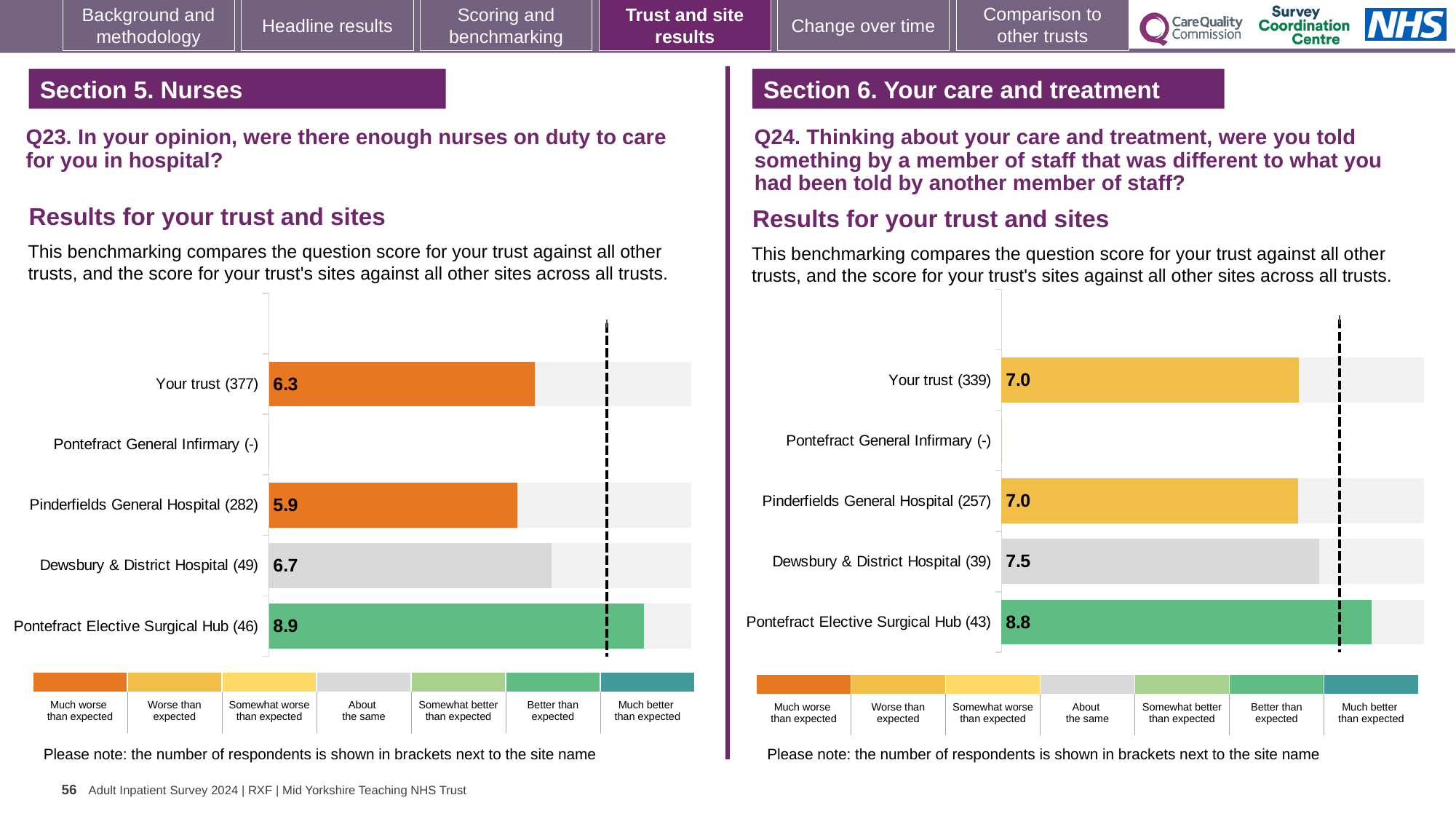
In the Q24 chart on the right, which is larger: the score for Your trust (339) or the score for Dewsbury & District Hospital (39)? Dewsbury & District Hospital (39) In the Q24 chart on the right, what is the score for Dewsbury & District Hospital (39)? 7.5 In the Q23 chart on the left, what is the score for Pinderfields General Hospital (282)? 5.9 In the Q23 chart on the left, what is the difference between the scores for Pontefract Elective Surgical Hub (46) and Dewsbury & District Hospital (49)? 2.2 In the Q24 chart on the right, which site has the highest score? Pontefract Elective Surgical Hub (43) In the Q23 chart on the left, which site has the lowest score? Pinderfields General Hospital (282) In the Q23 chart on the left, what is the score for Your trust (377)? 6.3 In the Q23 chart on the left, how many categories are listed on the vertical axis? 5 In the Q23 chart on the left, which site has the highest score? Pontefract Elective Surgical Hub (46) What kind of chart is used for the Q23 results on the left? Bar chart In the Q24 chart on the right, what is the difference between the scores for Pontefract Elective Surgical Hub (43) and Your trust (339)? 1.8 In the Q24 chart on the right, what is the score for Pontefract Elective Surgical Hub (43)? 8.8